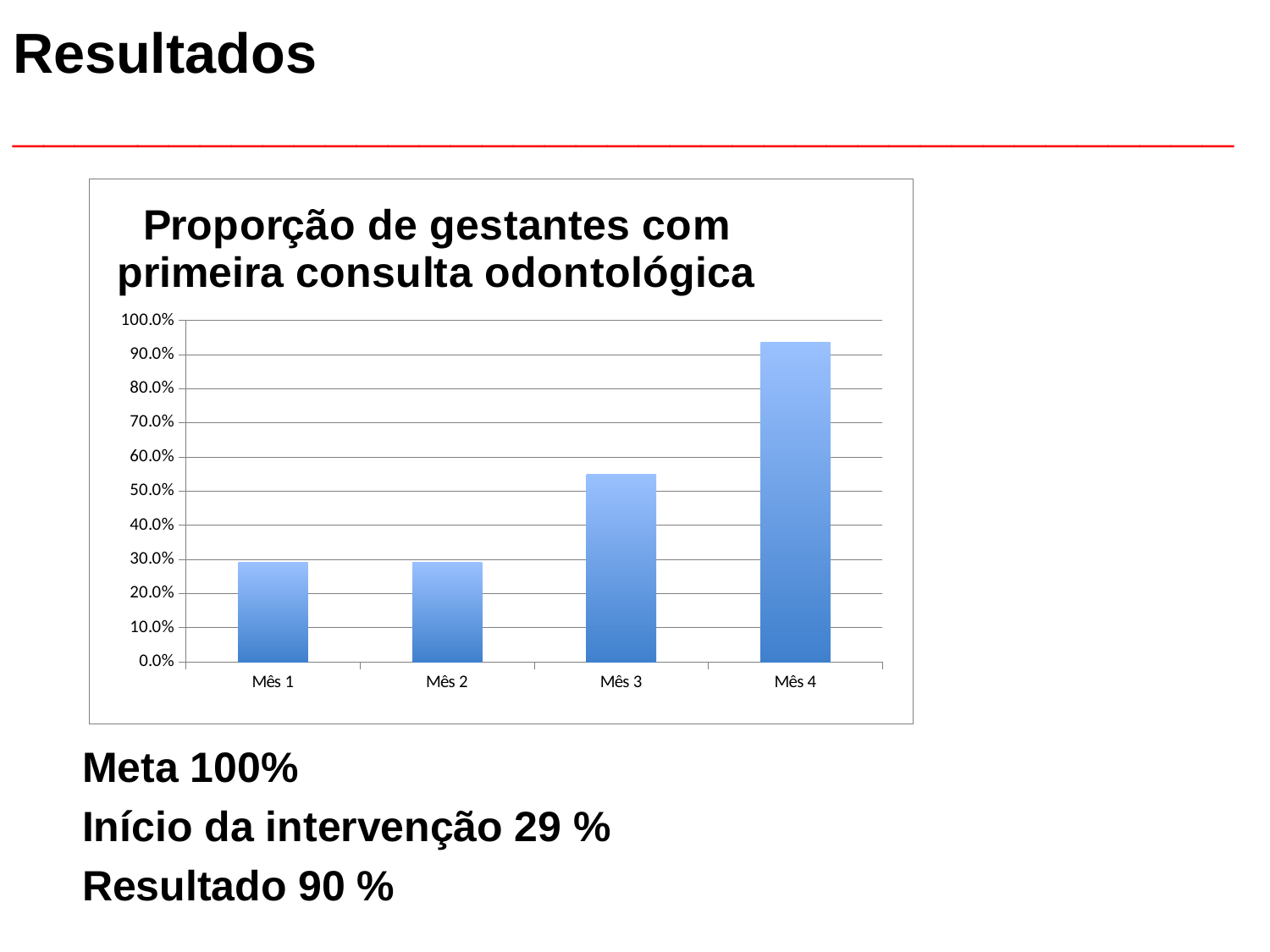
Do the values generally rise or fall from Mês 1 to Mês 4? rise What is the title of the chart? Proporção de gestantes com primeira consulta odontológica Is the value for Mês 3 greater or less than 50.0%? greater How many months (categories) are plotted on the x axis? 4 Which is larger, the value for Mês 4 or the value for Mês 3? Mês 4 Is the value for Mês 4 greater or less than 90.0%? greater Is the value for Mês 1 greater or less than 40.0%? less Which is larger, the value for Mês 3 or the value for Mês 2? Mês 3 What is the maximum value shown on the y axis? 100.0% Which month has the highest proportion? Mês 4 What kind of chart is shown on the slide? bar chart